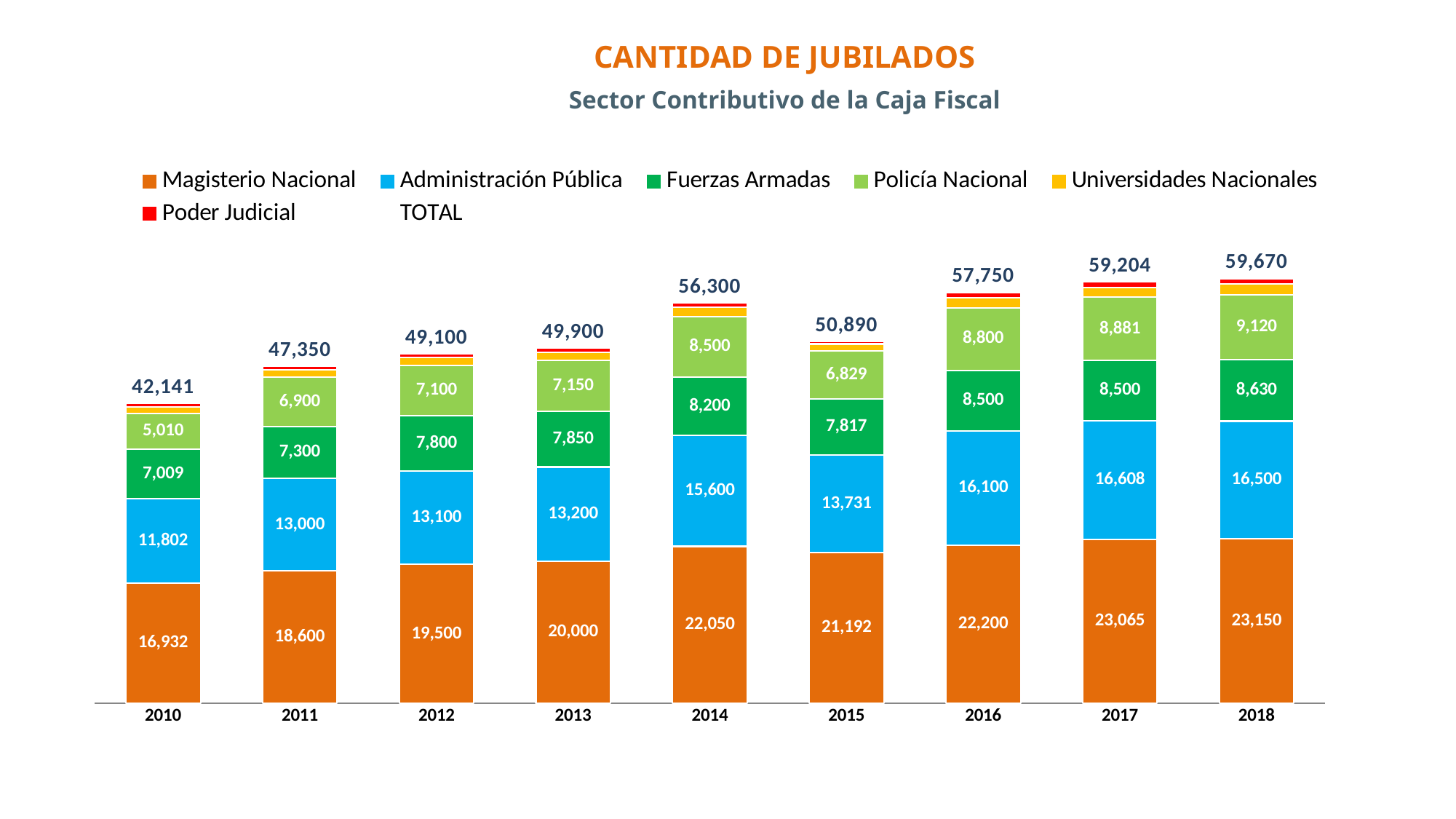
How many entries does the legend list? 7 What is the value for Policía Nacional in 2018? 9,120 What is the difference between the totals for 2018 and 2017? 466 What is the value for Magisterio Nacional in 2014? 22,050 Which year has the lowest total number of jubilados? 2010 What is the value for Administración Pública in 2017? 16,608 Which year has the highest total number of jubilados? 2018 Which year has the larger Magisterio Nacional value, 2015 or 2016? 2016 What is the total shown above the 2016 bar? 57,750 What kind of chart is shown on the slide? Stacked bar chart How many years are shown on the x axis? 9 What is the difference between the Fuerzas Armadas values for 2013 and 2012? 50